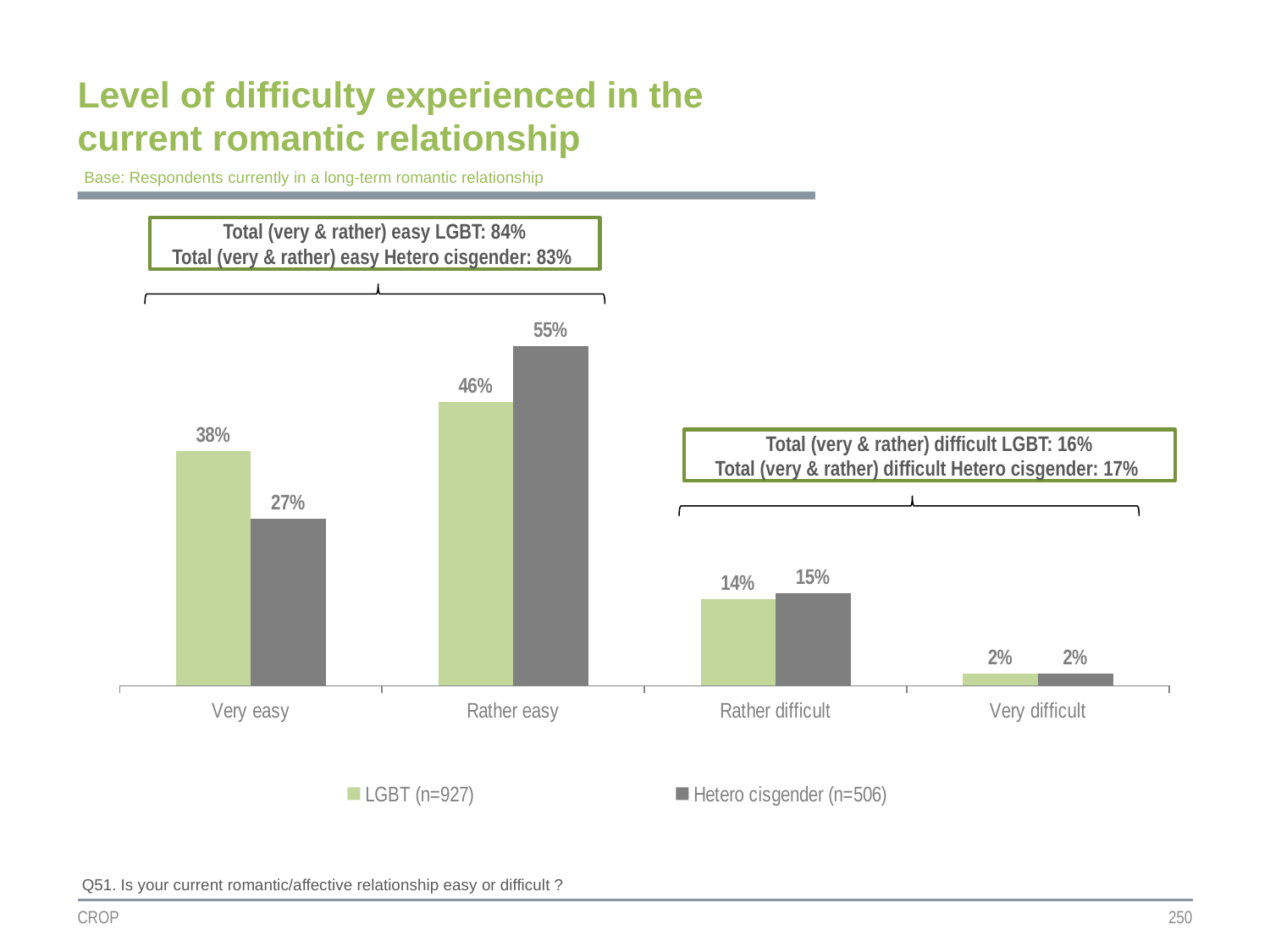
How many series does the legend list? 2 What is the sample size for the Hetero cisgender group shown in the legend? n=506 What is the difference between the LGBT and Hetero cisgender values for Very easy? 11 percentage points How many response categories are shown on the x axis? 4 What percentage of LGBT respondents said their relationship is very easy? 38% What kind of chart is shown on the slide? Bar chart Which category has the lowest value for Hetero cisgender respondents? Very difficult According to the text box, what is the total (very & rather) easy percentage for LGBT respondents? 84% What percentage of Hetero cisgender respondents said their relationship is rather easy? 55% What is the value for Hetero cisgender respondents in the Rather difficult category? 15% Which category has the highest value for LGBT respondents? Rather easy Which group has the larger value for Rather easy, LGBT or Hetero cisgender? Hetero cisgender